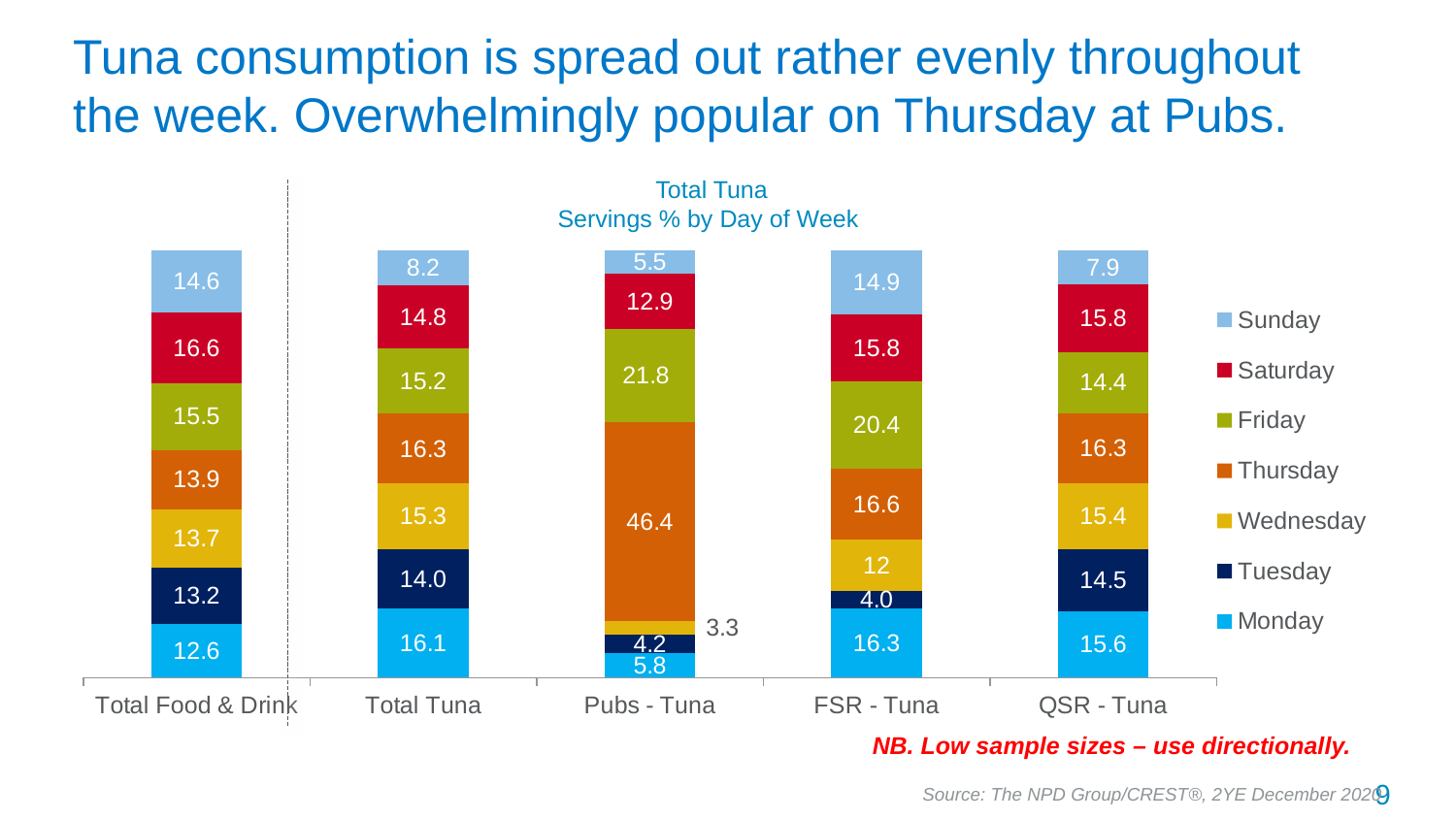
What is the Friday value for FSR - Tuna? 20.4 How many series does the legend list? 7 What kind of chart is shown on the slide? Stacked bar chart What is the Thursday value for Pubs - Tuna? 46.4 What is the difference between the Sunday values for FSR - Tuna and QSR - Tuna? 7.0 How many categories are shown on the x axis? 5 Which category has the highest Thursday value? Pubs - Tuna Which category has the lowest Tuesday value? FSR - Tuna What is the difference between the Thursday and Friday values for Pubs - Tuna? 24.6 What is the Sunday value for Total Tuna? 8.2 What is the Monday value for Total Food & Drink? 12.6 Which has the larger Saturday value, Total Food & Drink or Total Tuna? Total Food & Drink